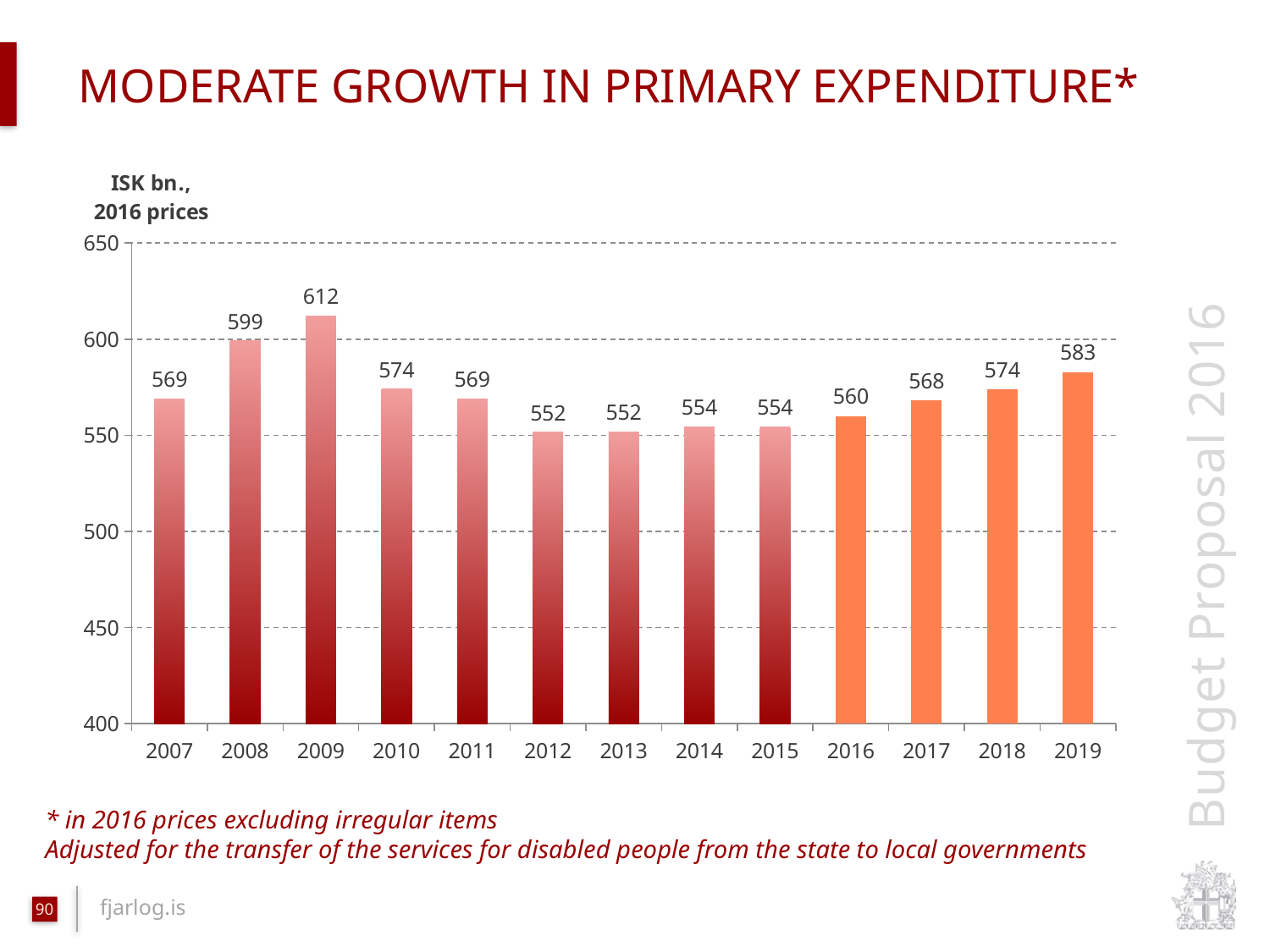
Is the value for 2008 greater or less than 600? less What is the difference between the values for 2019 and 2015? 29 What is the value for 2016? 560 Which is larger, the value for 2010 or the value for 2017? 2010 What is the lowest value shown on the chart? 552 Which year has the highest value? 2009 What kind of chart is shown on the slide? bar chart Do the values rise or fall from 2015 to 2019? rise What is the value for 2019? 583 How many years are shown on the x axis? 13 What is the value for 2009? 612 What is the difference between the values for 2009 and 2008? 13